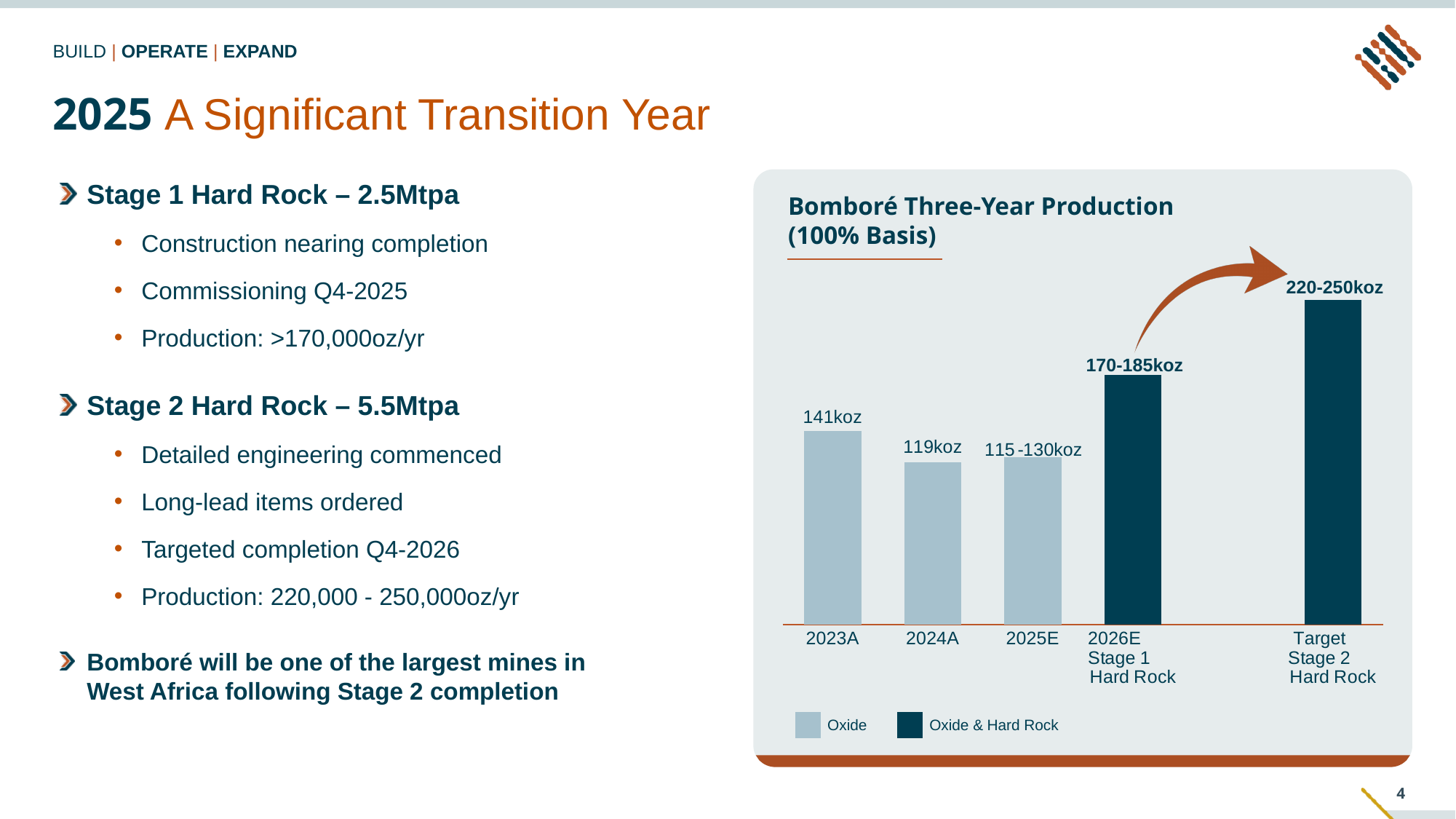
What kind of chart is shown on the slide? Bar chart Which bar in the chart is the highest? Target Stage 2 Hard Rock How many series does the legend list? 2 What is the production value shown for 2023A? 141koz What production range is shown for Target Stage 2 Hard Rock? 220-250koz Do the values rise or fall from 2024A to Target Stage 2 Hard Rock? Rise How many bars are plotted in the chart? 5 What is the difference between the 2023A and 2024A production values? 22koz What production range is shown for 2026E Stage 1 Hard Rock? 170-185koz What is the production value shown for 2024A? 119koz What production range is shown for 2025E? 115-130koz Which is larger, the production for 2023A or for 2024A? 2023A